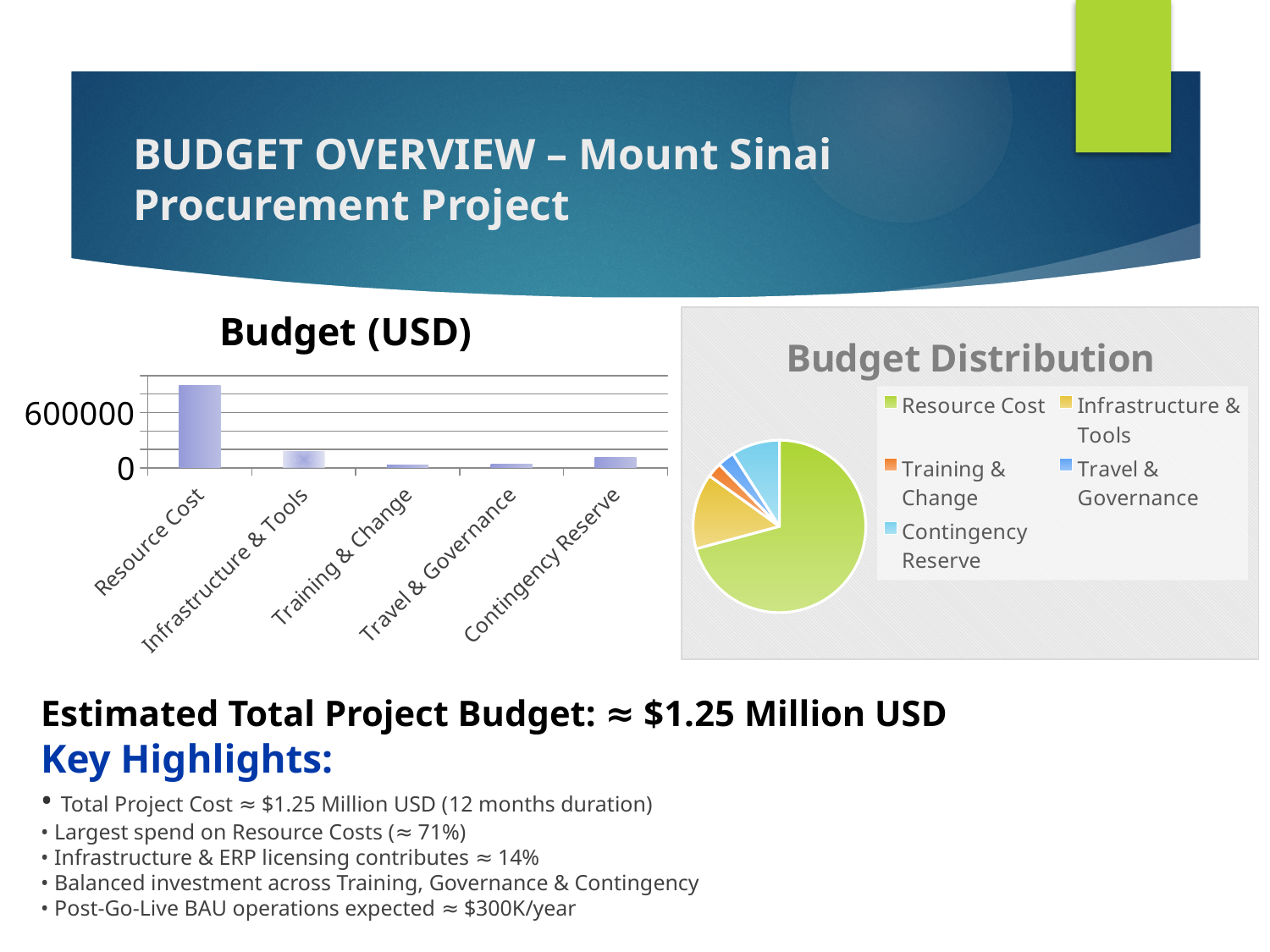
In the "Budget (USD)" bar chart, which is larger: Infrastructure & Tools or Contingency Reserve? Infrastructure & Tools In the "Budget Distribution" pie chart, which colour represents Resource Cost? green What kind of chart is the "Budget Distribution" chart on the right? pie chart In the "Budget (USD)" bar chart, which is larger: Contingency Reserve or Training & Change? Contingency Reserve In the "Budget (USD)" bar chart, which category has the highest value? Resource Cost In the "Budget (USD)" bar chart, how many categories are shown on the x axis? 5 In the "Budget Distribution" pie chart, which category has the largest slice? Resource Cost In the "Budget Distribution" pie chart, how many entries does the legend list? 5 In the "Budget (USD)" bar chart, is the value for Resource Cost greater or less than 600000? greater What kind of chart is the "Budget (USD)" chart on the left? bar chart In the "Budget (USD)" bar chart, is the value for Contingency Reserve greater or less than 600000? less In the "Budget (USD)" bar chart, is the value for Infrastructure & Tools greater or less than 600000? less